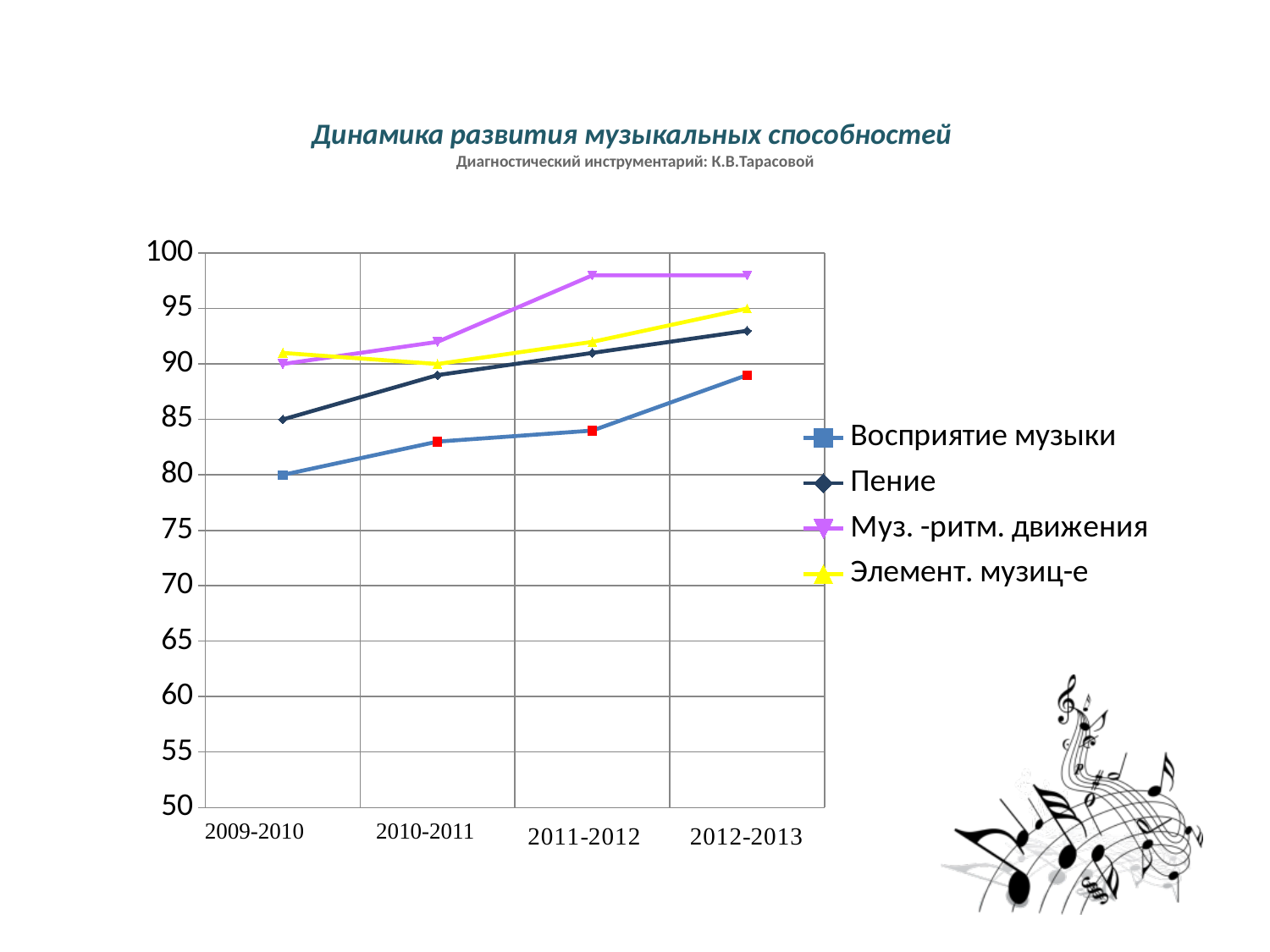
In 2011-2012, which is larger: Пение or Восприятие музыки? Пение What is the value for Восприятие музыки in 2009-2010? 80 How many school-year categories are shown on the x axis? 4 What is the value for Пение in 2009-2010? 85 Does the Восприятие музыки series rise or fall from 2009-2010 to 2012-2013? rises Which series has the lowest value in 2009-2010? Восприятие музыки Is the value for Восприятие музыки in 2012-2013 greater or less than 90? less What is the value for Элемент. музиц-е in 2012-2013? 95 How many series does the legend list? 4 Which series has the highest value in 2012-2013? Муз. -ритм. движения What type of chart is shown on the slide? line chart Is the value for Муз. -ритм. движения in 2012-2013 greater or less than 95? greater